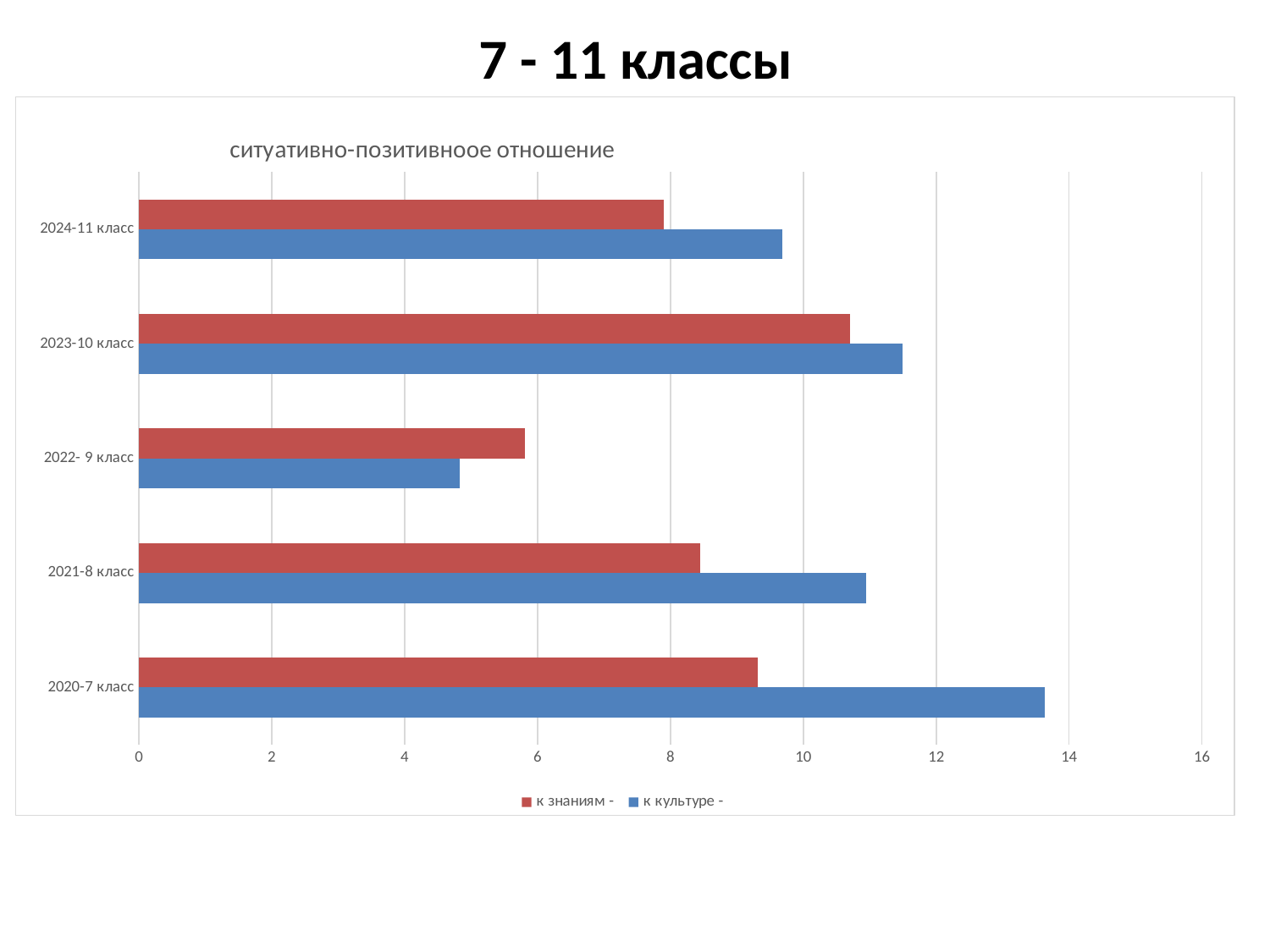
How many categories (class years) are shown on the chart? 5 Which category has the lowest value for the series 'к культуре -'? 2022- 9 класс What is the title of the chart? ситуативно-позитивноое отношение For 2022- 9 класс, which series has the larger value, 'к знаниям -' or 'к культуре -'? к знаниям - Is the value for 'к культуре -' in 2023-10 класс greater or less than 10? greater Is the value for 'к культуре -' in 2020-7 класс greater or less than 12? greater Is the value for 'к знаниям -' in 2022- 9 класс greater or less than 6? less Which category has the highest value for the series 'к культуре -'? 2020-7 класс Which category has the highest value for the series 'к знаниям -'? 2023-10 класс How many series does the legend list? 2 Which category has the lowest value for the series 'к знаниям -'? 2022- 9 класс What kind of chart is shown on the slide? bar chart